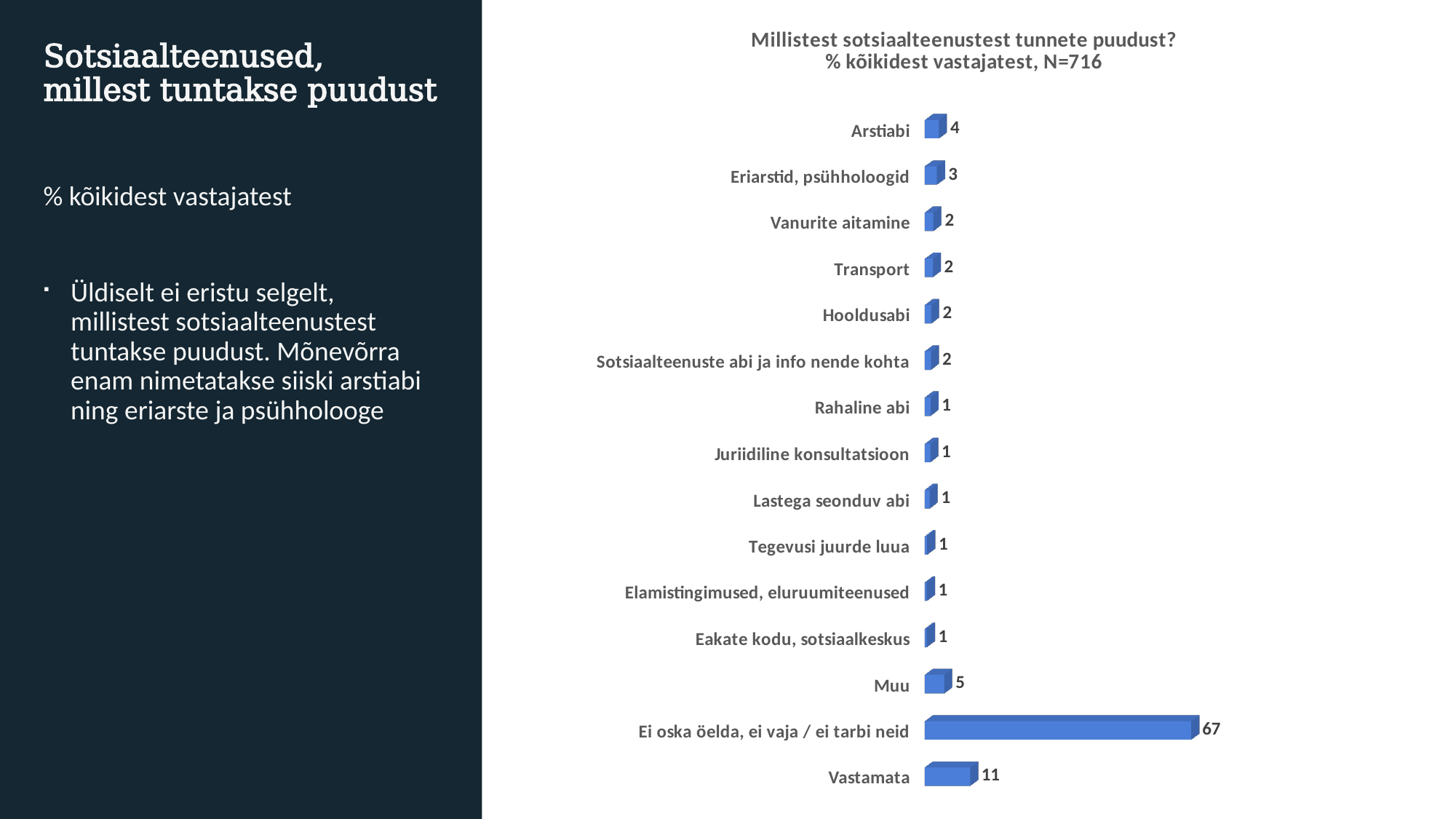
What is the value for Muu? 5 What is the difference between the values for Arstiabi and Eriarstid, psühholoogid? 1 How many categories are shown in the chart? 15 What is the value for Vastamata? 11 What is the value for Eriarstid, psühholoogid? 3 Which is larger, the value for Muu or the value for Arstiabi? Muu What is the N value stated in the chart title? N=716 What is the difference between the values for Ei oska öelda, ei vaja / ei tarbi neid and Vastamata? 56 What is the value for Hooldusabi? 2 Which category has the highest value? Ei oska öelda, ei vaja / ei tarbi neid What kind of chart is shown on the slide? Bar chart What is the value for Arstiabi? 4